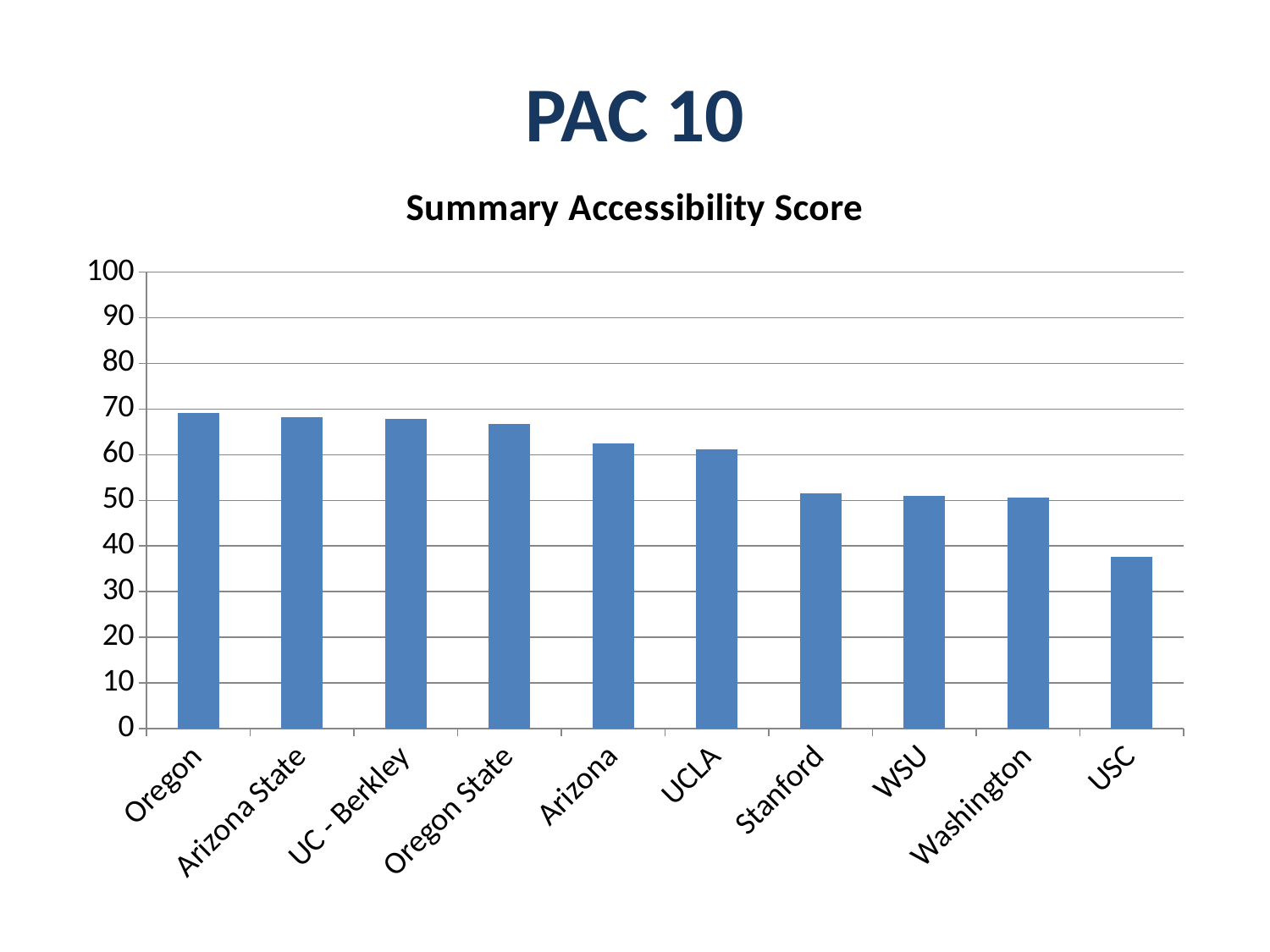
What kind of chart is shown on the slide? bar chart Is the value for Oregon State greater or less than 70? less Do the values rise or fall moving from left to right along the x axis? fall How many schools are shown on the x axis of the chart? 10 What is the title of the chart? Summary Accessibility Score Is the value for USC greater or less than 40? less Which has the larger value, USC or Washington? Washington Is the value for Arizona greater or less than 60? greater Which school has the lowest Summary Accessibility Score? USC Which has the larger value, Arizona or Stanford? Arizona